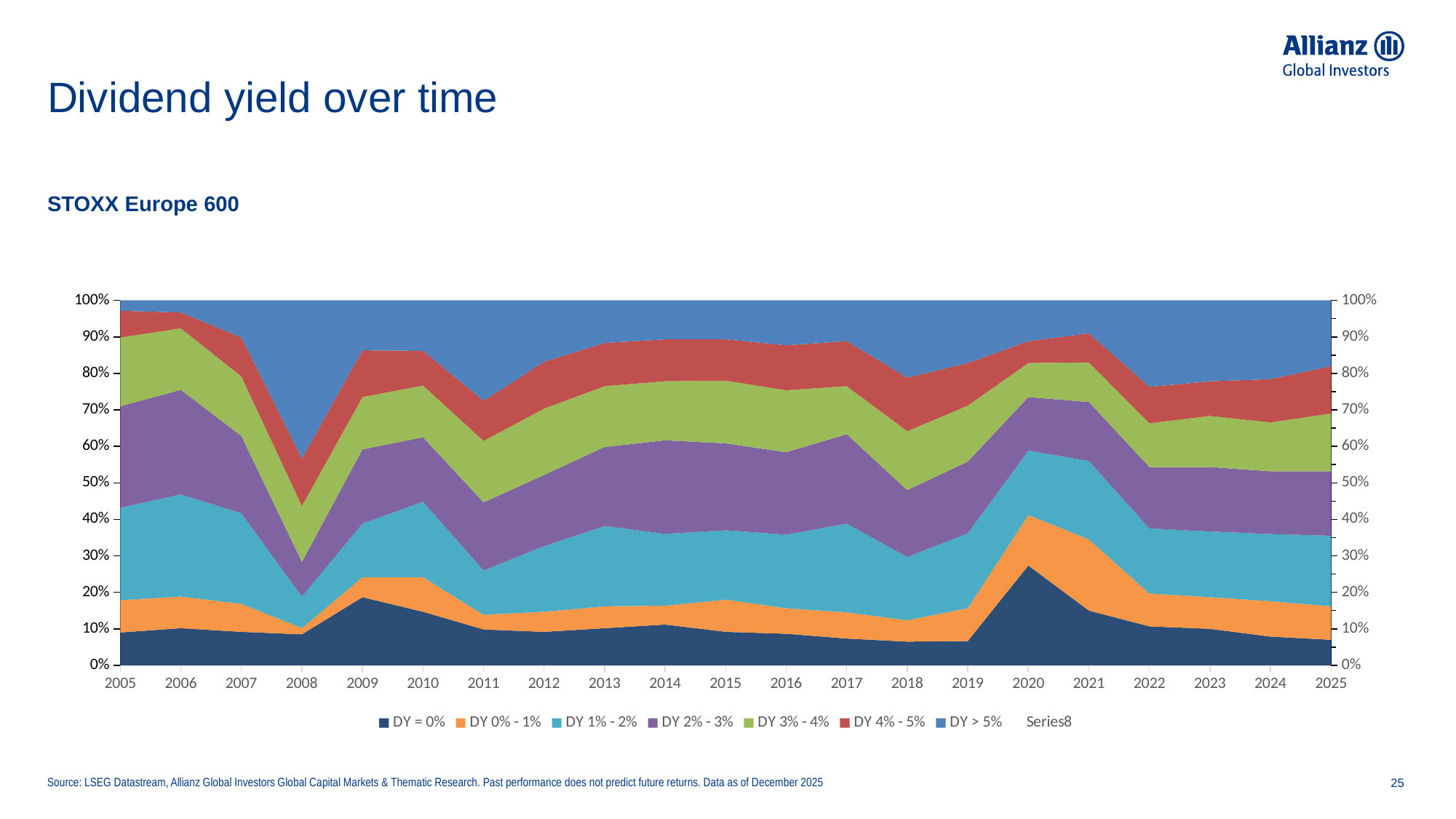
Is the share for DY = 0% in 2008 greater or less than 10%? less Is the share for DY = 0% in 2020 greater or less than 20%? greater How many series does the chart's legend list? 8 Which year has the highest share for DY > 5%? 2008 What kind of chart is shown on the slide? Stacked area chart Which year has the highest share for DY = 0%? 2020 What is the last entry listed in the chart's legend? Series8 Which is larger, the share for DY = 0% in 2020 or in 2009? 2020 How many years are plotted along the x axis of the chart? 21 Is the share for DY > 5% in 2008 greater or less than 30%? greater Does the share for DY = 0% rise or fall from 2020 to 2025? fall What index does the chart cover, according to the subtitle? STOXX Europe 600